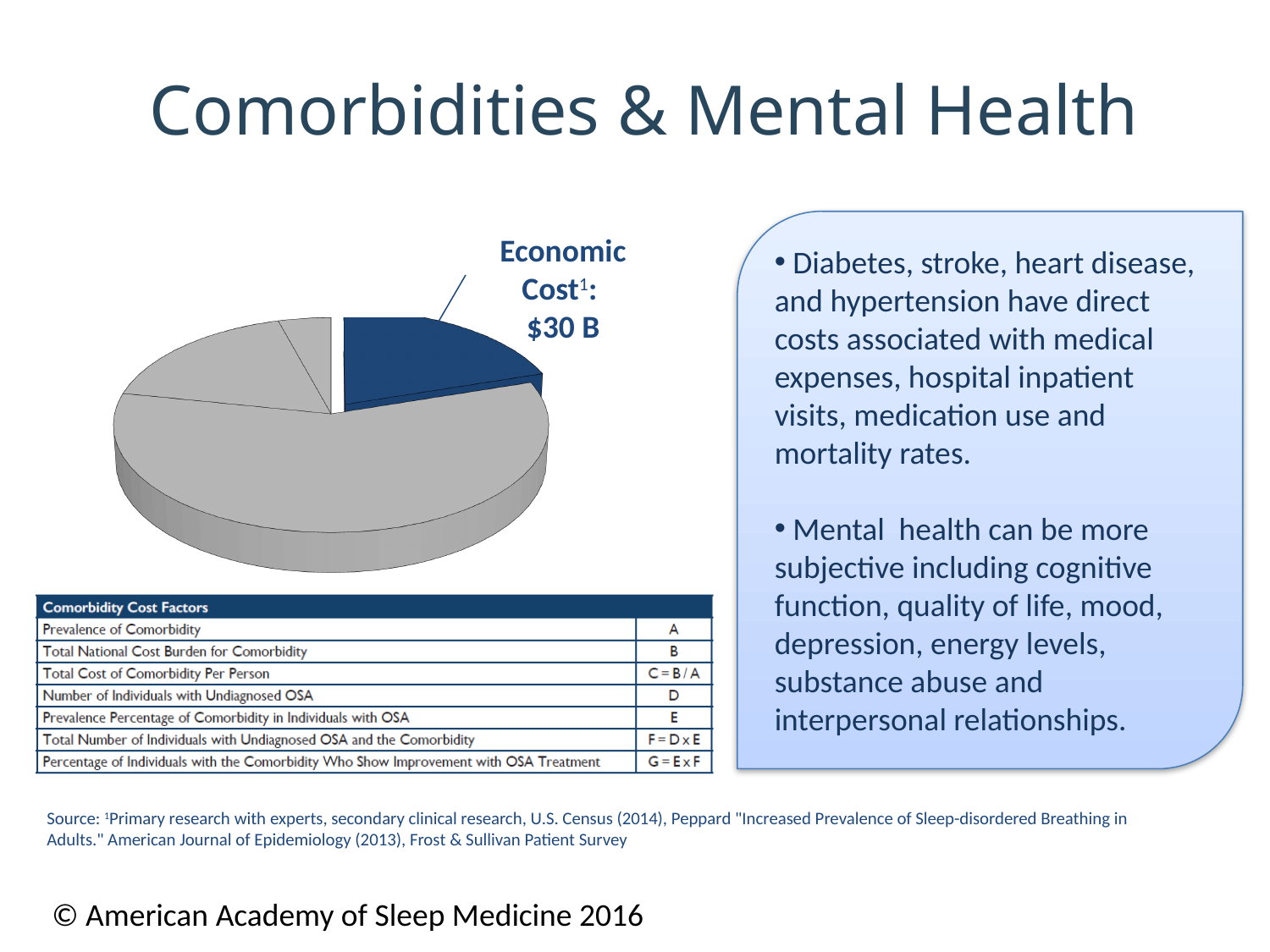
What kind of chart is shown on the slide? pie chart What colour is the highlighted slice of the pie chart? blue Is the Economic Cost slice the largest slice of the pie chart? No How many slices does the pie chart have? 4 What is the label of the highlighted (exploded) slice of the pie chart? Economic Cost What value is labelled on the highlighted slice of the pie chart? $30 B